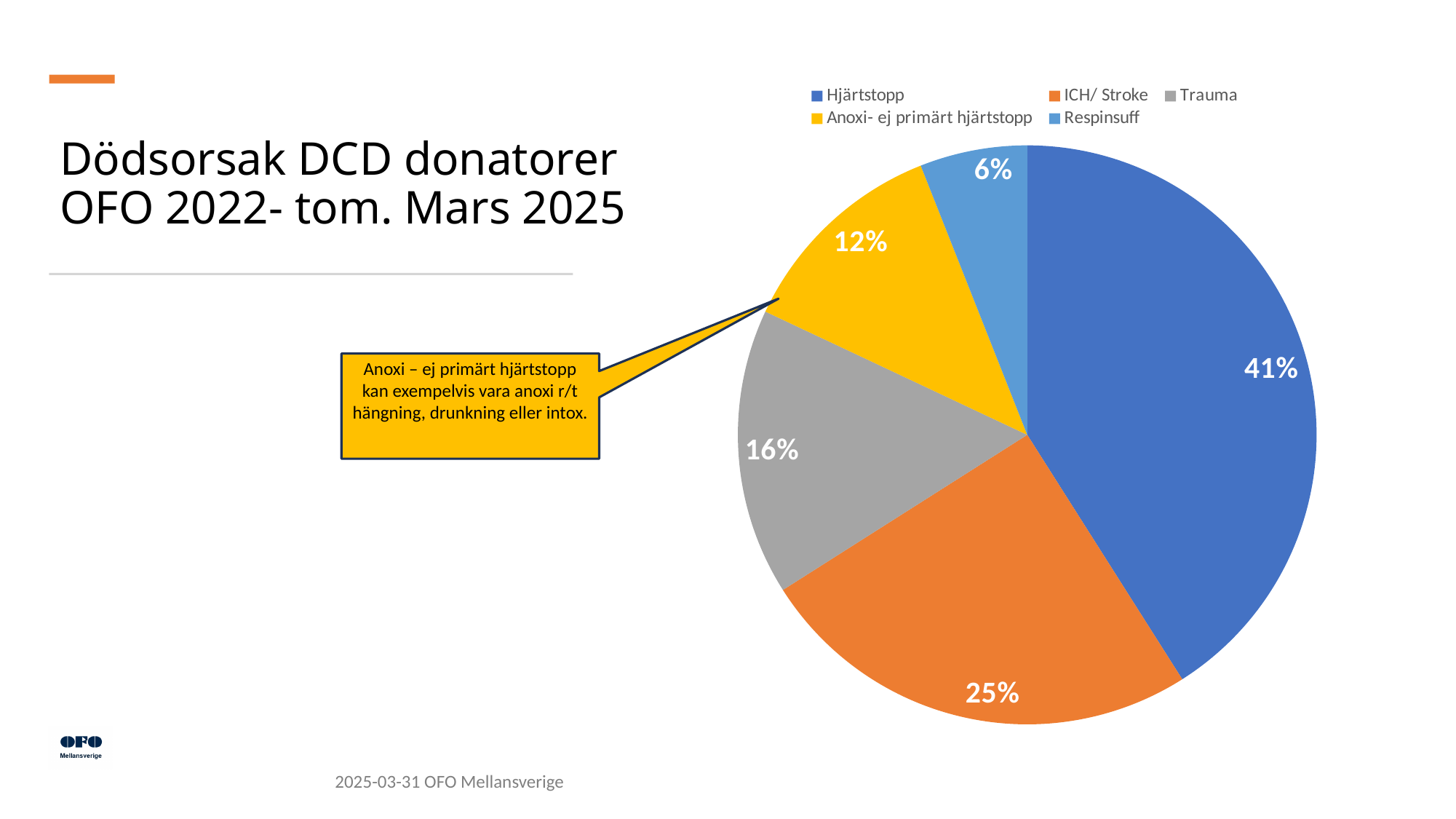
What colour is the Trauma slice? Grey What is the value shown for Trauma? 16% What is the value shown for Respinsuff? 6% What is the value shown for ICH/ Stroke? 25% Which category has the largest slice of the pie? Hjärtstopp What kind of chart is shown on the slide? Pie chart What share of the pie does Hjärtstopp account for? 41% What is the difference in percentage points between Hjärtstopp and ICH/ Stroke? 16 How many categories does the pie chart have? 5 What is the value shown for Anoxi- ej primärt hjärtstopp? 12% Which category has the smallest slice of the pie? Respinsuff Which is larger, Trauma or Anoxi- ej primärt hjärtstopp? Trauma